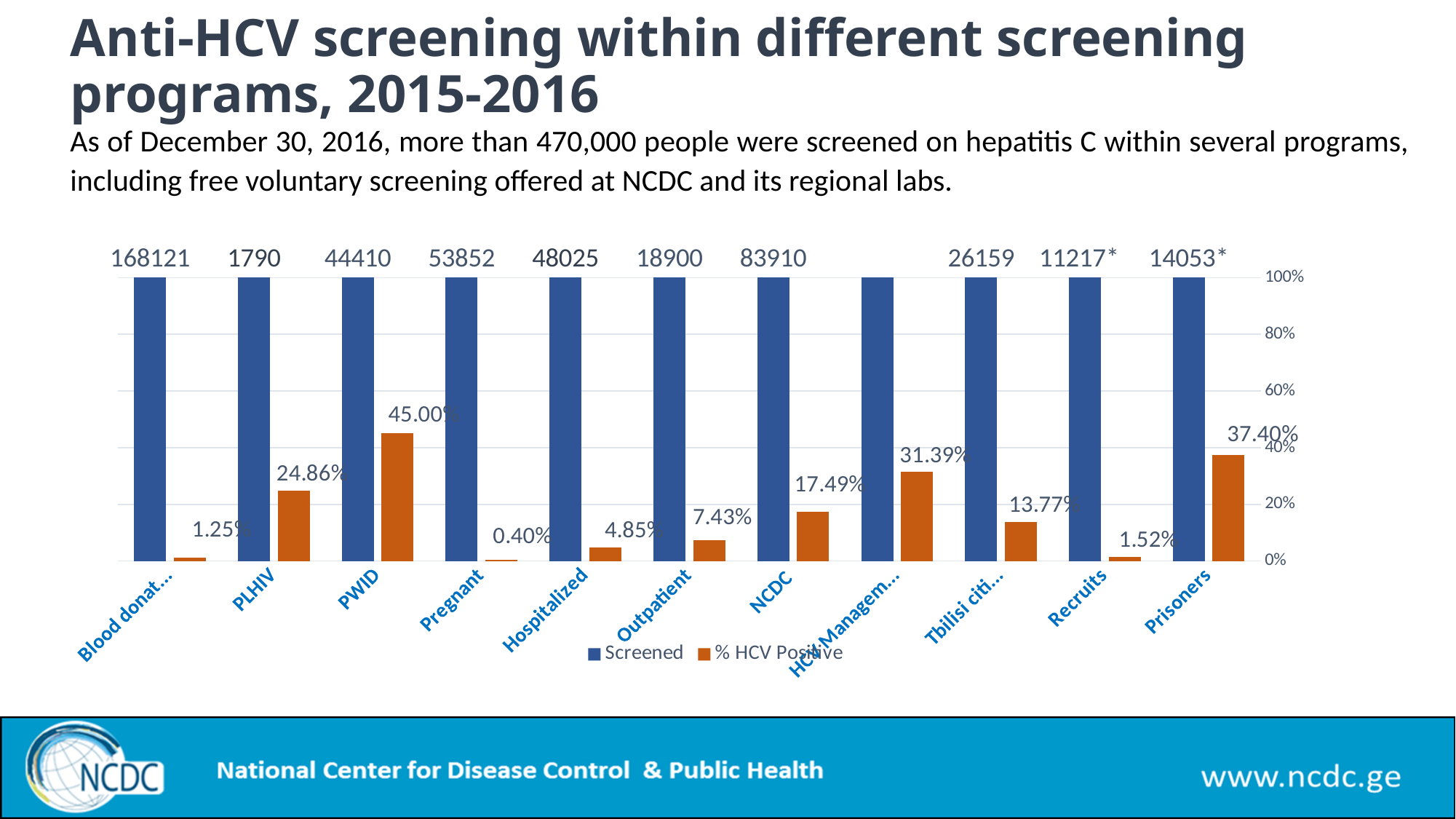
What is the % HCV Positive value for Prisoners? 37.40% Which category has the lowest % HCV Positive? Pregnant How many categories are shown on the x axis? 11 What is the difference in % HCV Positive between PWID and PLHIV? 20.14% How many people were screened in the PLHIV program? 1790 What is the Screened value for NCDC? 83910 Which category has the lowest Screened value among those with a printed label? PLHIV What kind of chart is shown on the slide? Bar chart What is the % HCV Positive value for PWID? 45.00% Which has a higher % HCV Positive, Hospitalized or Outpatient? Outpatient Which category has the highest % HCV Positive? PWID How many series does the legend list? 2